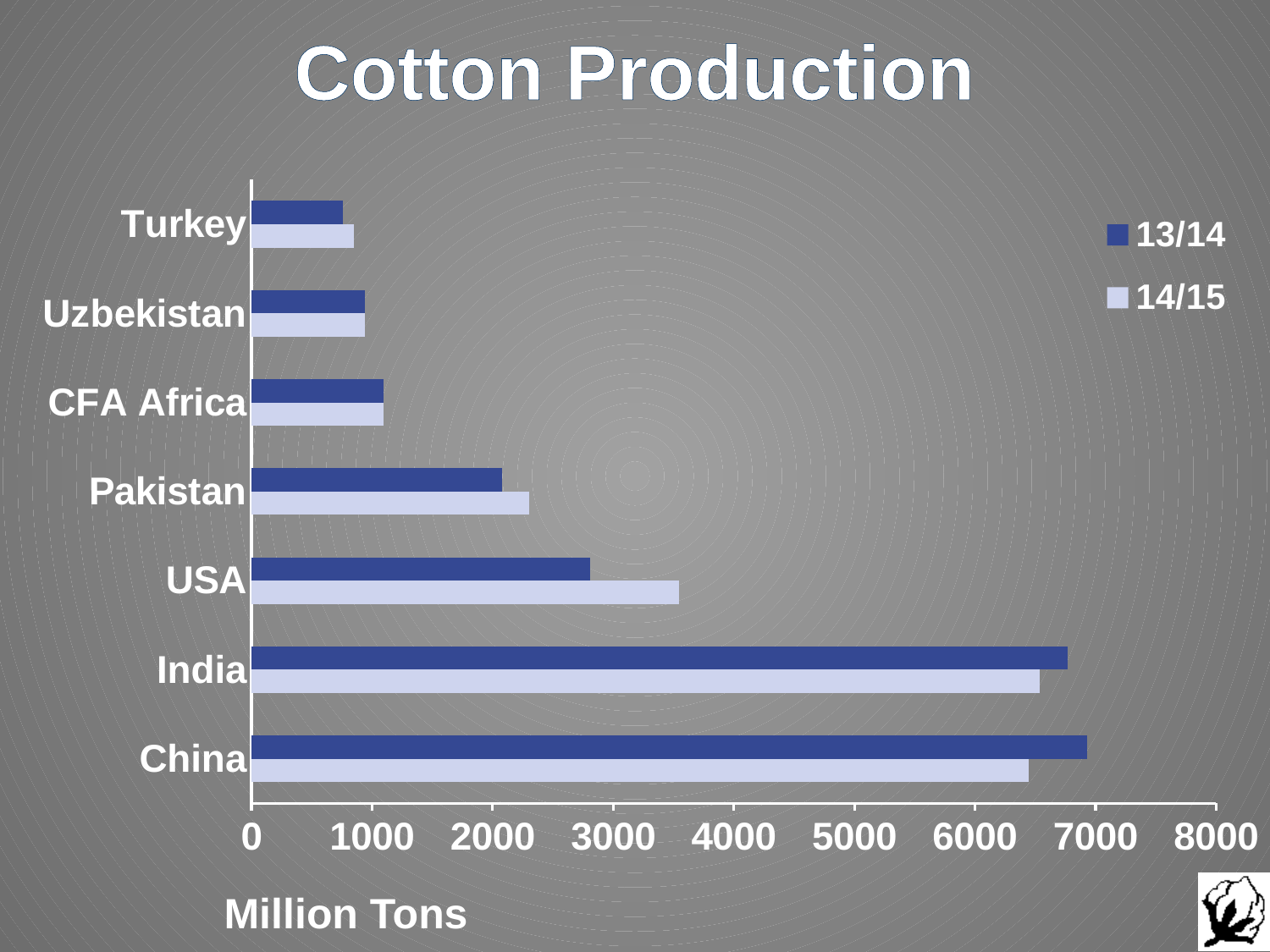
Is the 14/15 value for USA greater or less than 3000? greater How many countries or regions are shown on the chart? 7 Is the 13/14 value for Turkey greater or less than 1000? less Is the 13/14 value for USA greater or less than 3000? less What kind of chart is shown on the slide? bar chart For China, which series has the larger value, 13/14 or 14/15? 13/14 Which country has the lowest cotton production in the 13/14 series? Turkey What unit label is shown below the horizontal axis? Million Tons In the 13/14 series, which is larger, USA or Pakistan? USA For USA, which series has the larger value, 13/14 or 14/15? 14/15 How many series does the legend list? 2